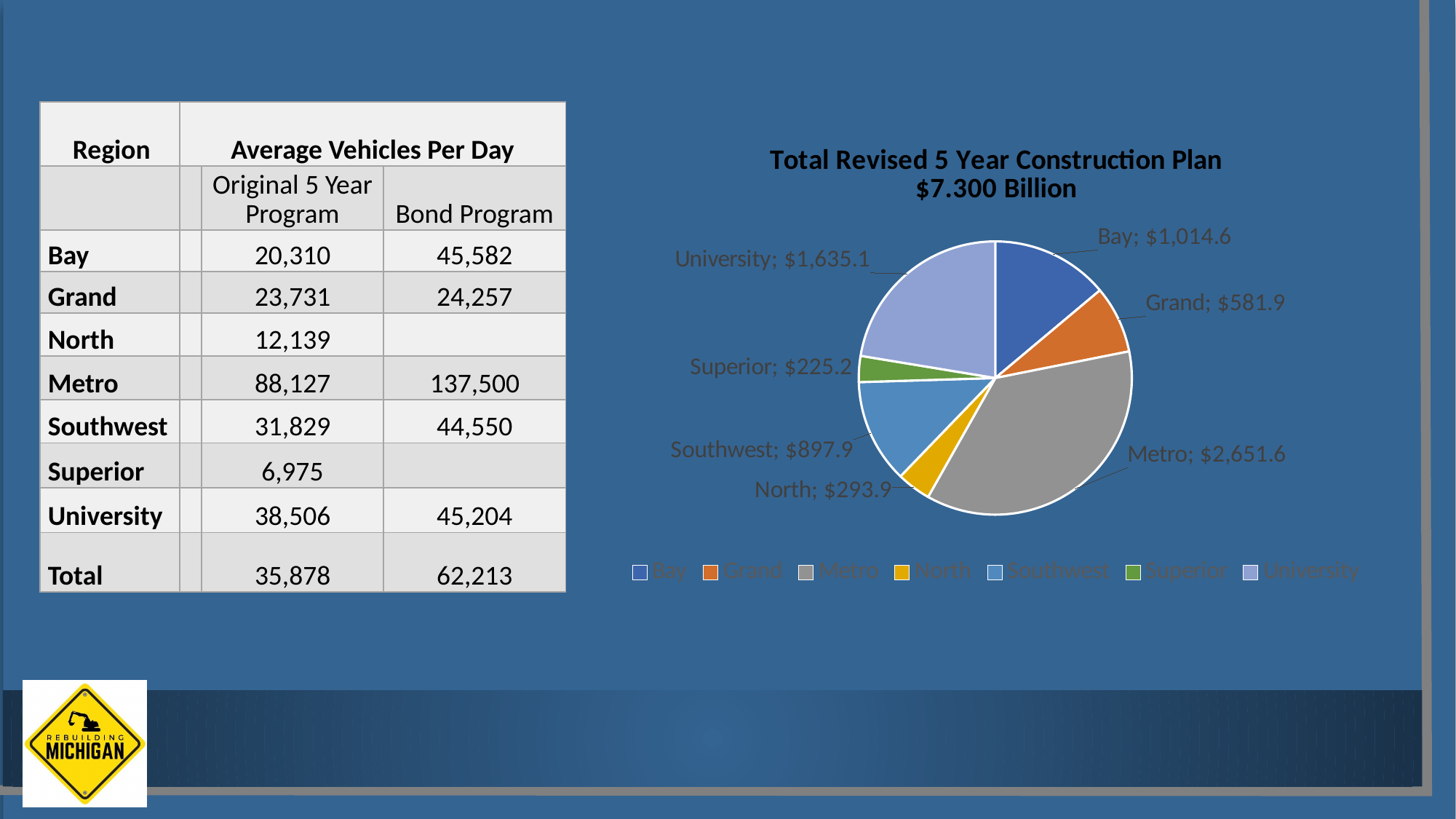
What is the title of the pie chart? Total Revised 5 Year Construction Plan $7.300 Billion How many entries does the pie chart's legend list? 7 In the pie chart, what is the value for University? $1,635.1 How many slices does the pie chart have? 7 In the pie chart, what is the value for Superior? $225.2 In the pie chart, what is the difference between the values for Metro and University? $1,016.5 Which region has the largest slice in the pie chart? Metro In the pie chart, which is larger, the value for Bay or the value for Grand? Bay What kind of chart is shown on the slide? Pie chart In the pie chart, what is the value for Southwest? $897.9 In the pie chart, what is the value for Metro? $2,651.6 Which region has the smallest slice in the pie chart? Superior